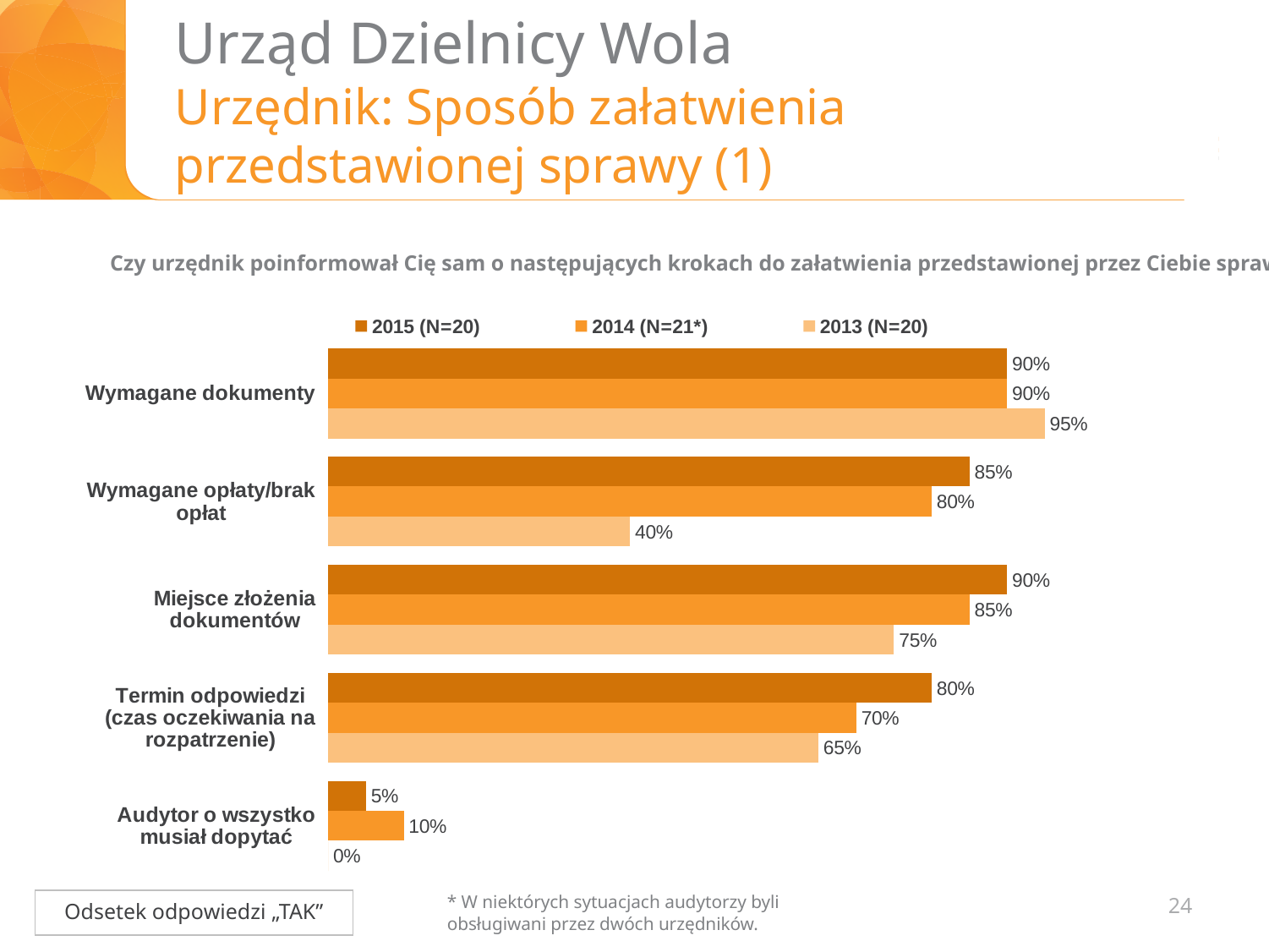
What is the difference between the 2015 (N=20) and 2013 (N=20) values for "Wymagane opłaty/brak opłat"? 45 percentage points What is the value for "Audytor o wszystko musiał dopytać" in the 2014 (N=21*) series? 10% What is the value for "Termin odpowiedzi (czas oczekiwania na rozpatrzenie)" in the 2015 (N=20) series? 80% How many series does the legend list? 3 For "Miejsce złożenia dokumentów", which series has the larger value: 2014 (N=21*) or 2013 (N=20)? 2014 (N=21*) Which category has the highest value in the 2013 (N=20) series? Wymagane dokumenty What is the value for "Wymagane opłaty/brak opłat" in the 2013 (N=20) series? 40% Which category has the lowest value in the 2015 (N=20) series? Audytor o wszystko musiał dopytać What kind of chart is shown on the slide? Bar chart How many categories are shown on the chart? 5 What is the value for "Wymagane dokumenty" in the 2013 (N=20) series? 95% What does the box at the bottom left of the chart say the values represent? Odsetek odpowiedzi „TAK”